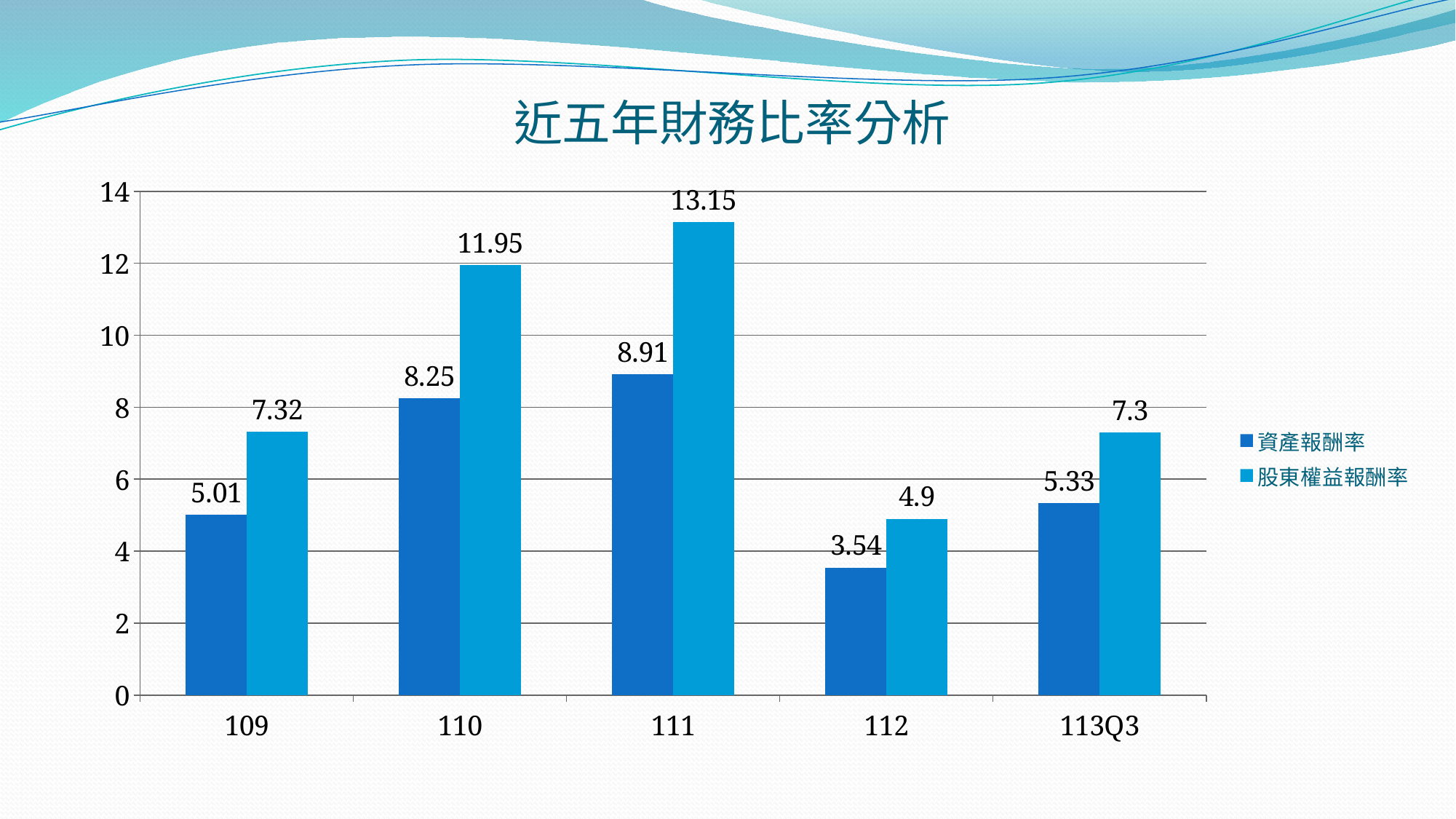
How many series does the legend list? 2 How many categories are shown on the x axis? 5 Which is larger for 109: 資產報酬率 or 股東權益報酬率? 股東權益報酬率 What is the 資產報酬率 value for 111? 8.91 Which category has the highest 股東權益報酬率? 111 What kind of chart is shown on the slide? bar chart Which category has the lowest 資產報酬率? 112 What is the difference between 股東權益報酬率 and 資產報酬率 for 110? 3.7 Is the 股東權益報酬率 value for 111 greater or less than 12? greater What is the title of the chart? 近五年財務比率分析 What is the 股東權益報酬率 value for 113Q3? 7.3 What is the 股東權益報酬率 value for 112? 4.9